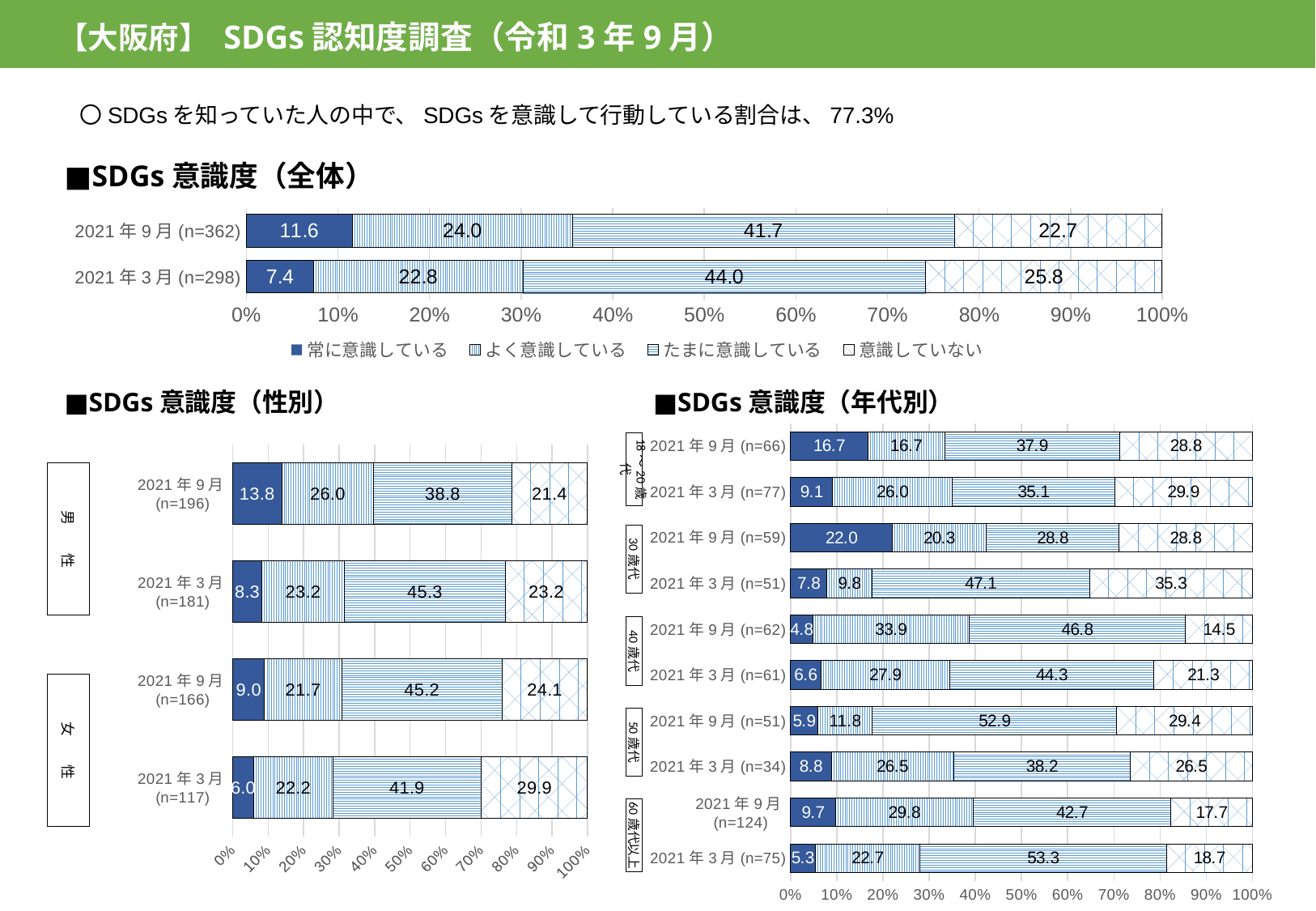
In the ■SDGs 意識度（年代別） chart, what is the たまに意識している value for 50歳代 2021年9月 (n=51)? 52.9 In the ■SDGs 意識度（全体） chart, what is the value for 常に意識している in 2021年9月 (n=362)? 11.6 What kind of chart is the ■SDGs 意識度（全体） chart? Stacked bar chart In the ■SDGs 意識度（性別） chart, which has the larger 常に意識している value: 男性 2021年9月 or 女性 2021年9月? 男性 2021年9月 How many bars are shown in the ■SDGs 意識度（年代別） chart? 10 In the ■SDGs 意識度（年代別） chart, which bar has the highest 常に意識している value? 30歳代 2021年9月 (n=59) In the ■SDGs 意識度（性別） chart, what is the たまに意識している value for 男性 2021年9月 (n=196)? 38.8 How many bars are shown in the ■SDGs 意識度（性別） chart? 4 In the ■SDGs 意識度（全体） chart, what is the difference between the たまに意識している values for 2021年3月 and 2021年9月? 2.3 In the ■SDGs 意識度（年代別） chart, which bar has the lowest 意識していない value? 40歳代 2021年9月 (n=62) How many series does the legend of the ■SDGs 意識度（全体） chart list? 4 In the ■SDGs 意識度（全体） chart, what is the value for 意識していない in 2021年3月 (n=298)? 25.8